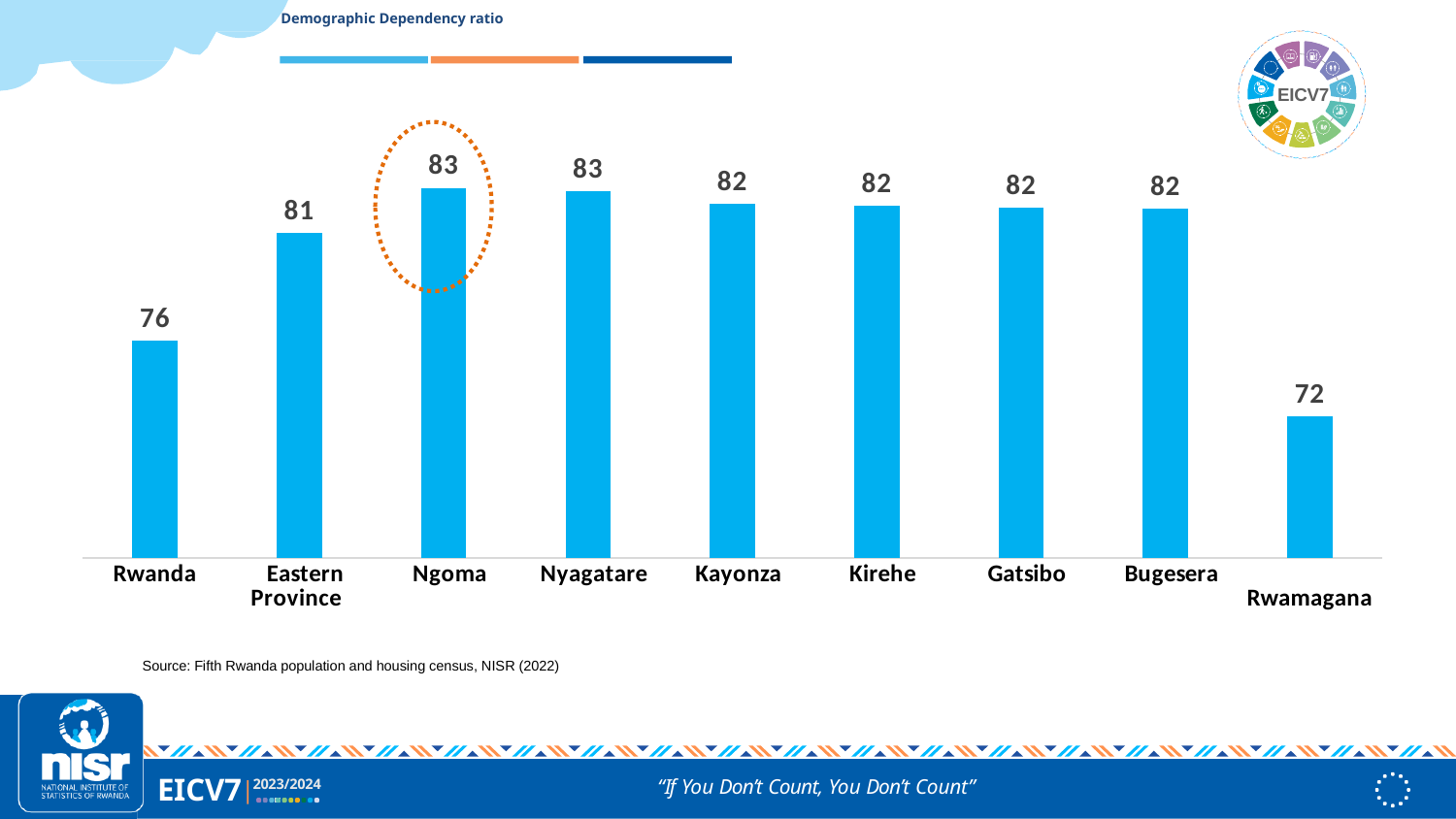
What is the demographic dependency ratio for Kirehe? 82 What is the difference between the dependency ratio of Eastern Province and that of Rwanda? 5 What is the demographic dependency ratio for Rwanda? 76 What is the demographic dependency ratio for Rwamagana? 72 Which category has the lowest demographic dependency ratio? Rwamagana Which has a higher dependency ratio, Rwanda or Eastern Province? Eastern Province What is the demographic dependency ratio for Eastern Province? 81 What is the demographic dependency ratio for Ngoma? 83 What is the difference between the dependency ratio of Ngoma and that of Rwamagana? 11 What kind of chart is shown on the slide? Bar chart Which bar on the chart is highlighted with a dotted orange circle? Ngoma How many categories are shown on the chart? 9